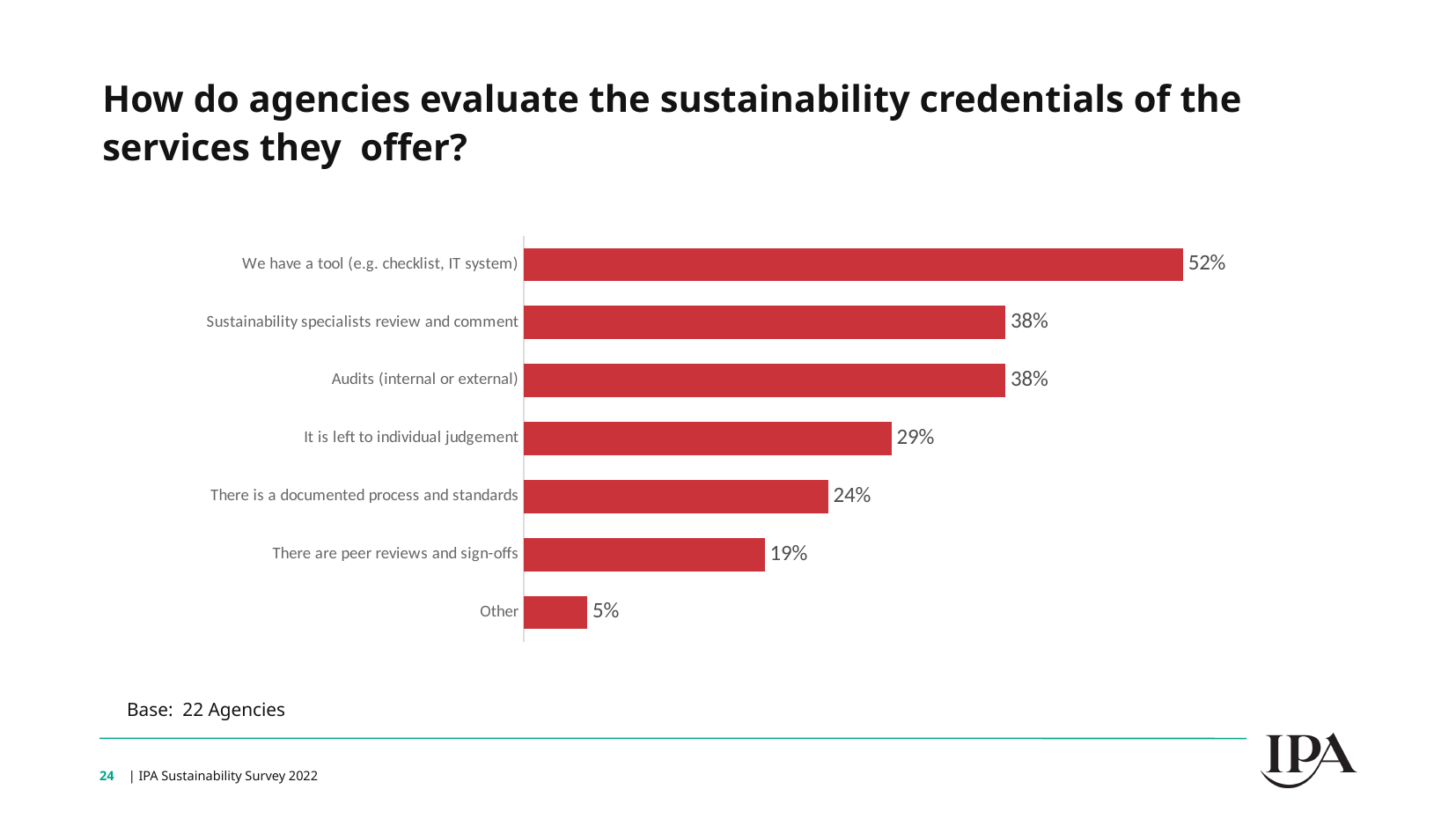
What is the value for 'Audits (internal or external)'? 38% What is the difference between 'We have a tool (e.g. checklist, IT system)' and 'There is a documented process and standards'? 28% What percentage is shown for 'There are peer reviews and sign-offs'? 19% What is the base (number of agencies) stated for the chart? 22 Agencies What percentage of agencies say they have a tool (e.g. checklist, IT system)? 52% What kind of chart is shown on the slide? Bar chart What is the value for 'It is left to individual judgement'? 29% Which category has the highest value? We have a tool (e.g. checklist, IT system) How many categories are shown in the chart? 7 Which is larger: 'It is left to individual judgement' or 'There is a documented process and standards'? It is left to individual judgement Which category has the lowest value? Other What colour are the bars in the chart? Red